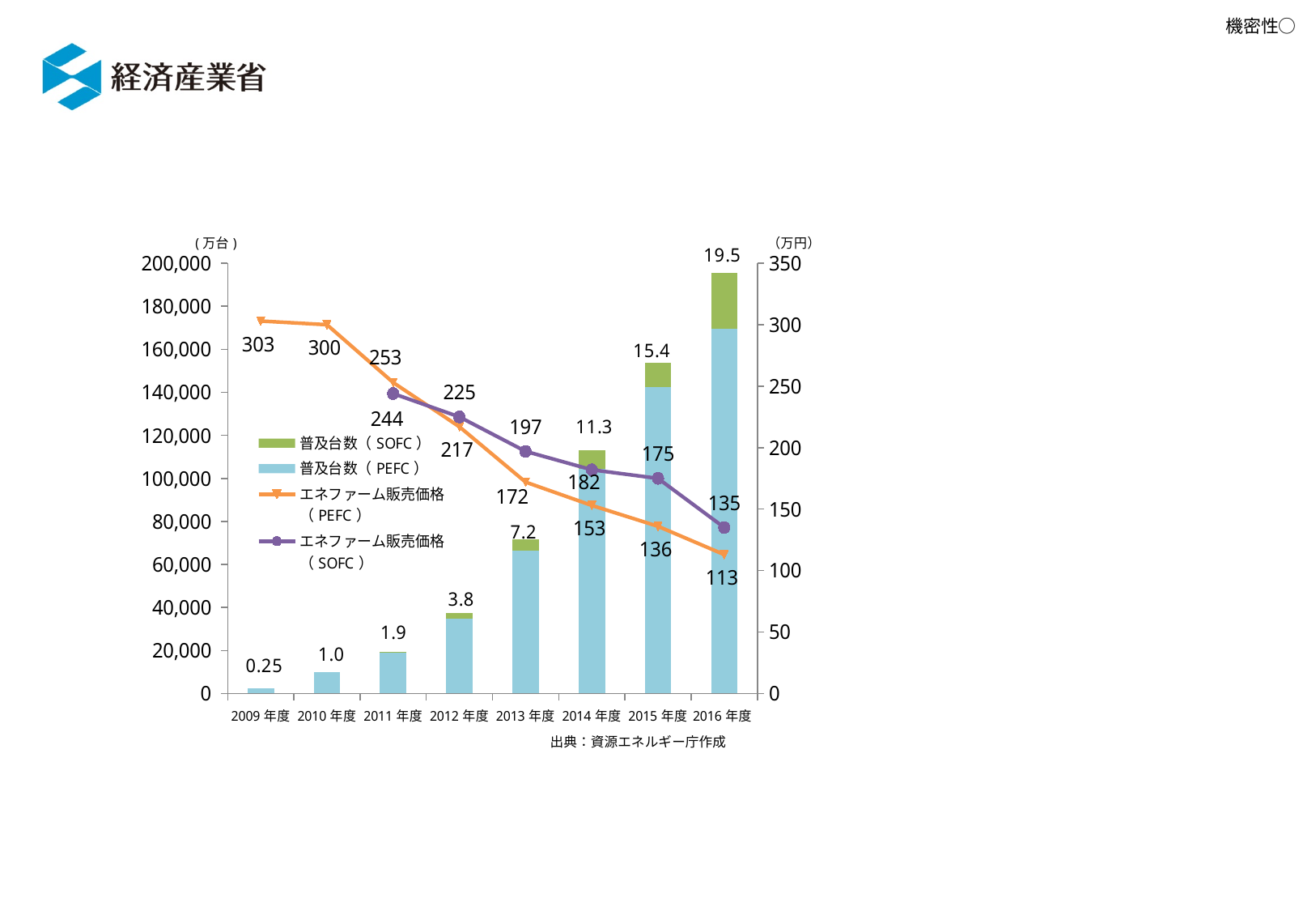
In which year is the エネファーム販売価格（PEFC） highest? 2009年度 What is the total 普及台数 label shown on the bar for 2016年度? 19.5 In which year is the エネファーム販売価格（SOFC） lowest? 2016年度 What kind of chart is shown on the slide? Combination stacked bar and line chart What is the エネファーム販売価格（PEFC） value for 2009年度? 303 What is the difference between the エネファーム販売価格（PEFC） in 2009年度 and in 2016年度? 190 How many fiscal years are shown on the x axis? 8 Does the エネファーム販売価格（PEFC） rise or fall from 2009年度 to 2016年度? fall What is the エネファーム販売価格（SOFC） value for 2014年度? 182 Do the 普及台数 bar totals rise or fall from 2009年度 to 2016年度? rise How many series does the legend list? 4 In 2013年度, which is larger: the エネファーム販売価格（PEFC） or the エネファーム販売価格（SOFC）? エネファーム販売価格（SOFC）